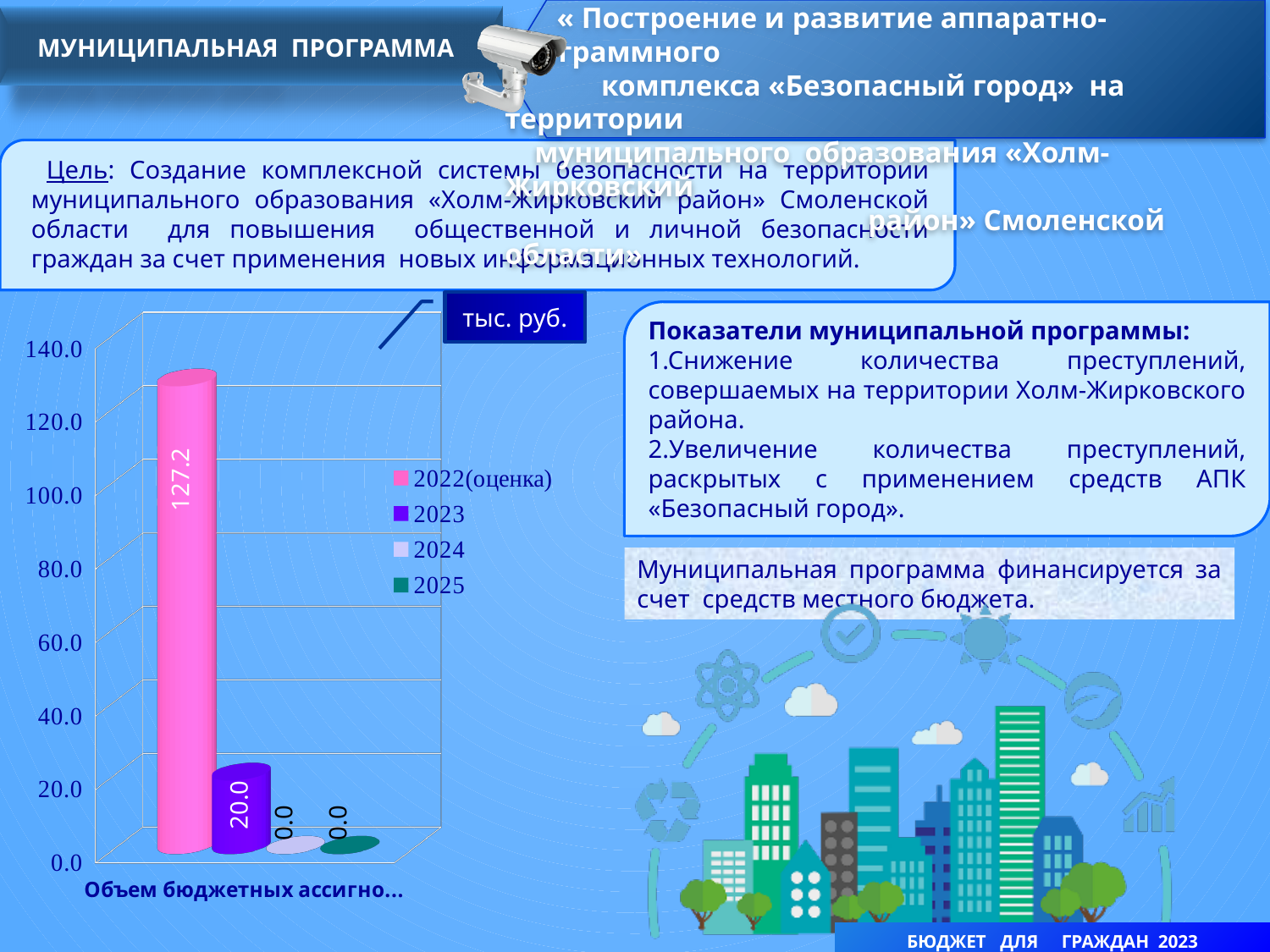
Is the value for 2022(оценка) greater or less than 120.0? greater What is the difference between the values for 2022(оценка) and 2023? 107.2 What unit of measurement is indicated for the chart values? тыс. руб. What is the value for 2025 in the chart? 0.0 What is the value for 2023 in the chart? 20.0 What kind of chart is shown on the slide? bar chart Which is larger, the value for 2022(оценка) or the value for 2023? 2022(оценка) Which series has the highest value in the chart? 2022(оценка) What is the value for 2024 in the chart? 0.0 What is the value for 2022(оценка) in the chart? 127.2 Is the value for 2023 greater or less than 40.0? less How many series does the chart legend list? 4